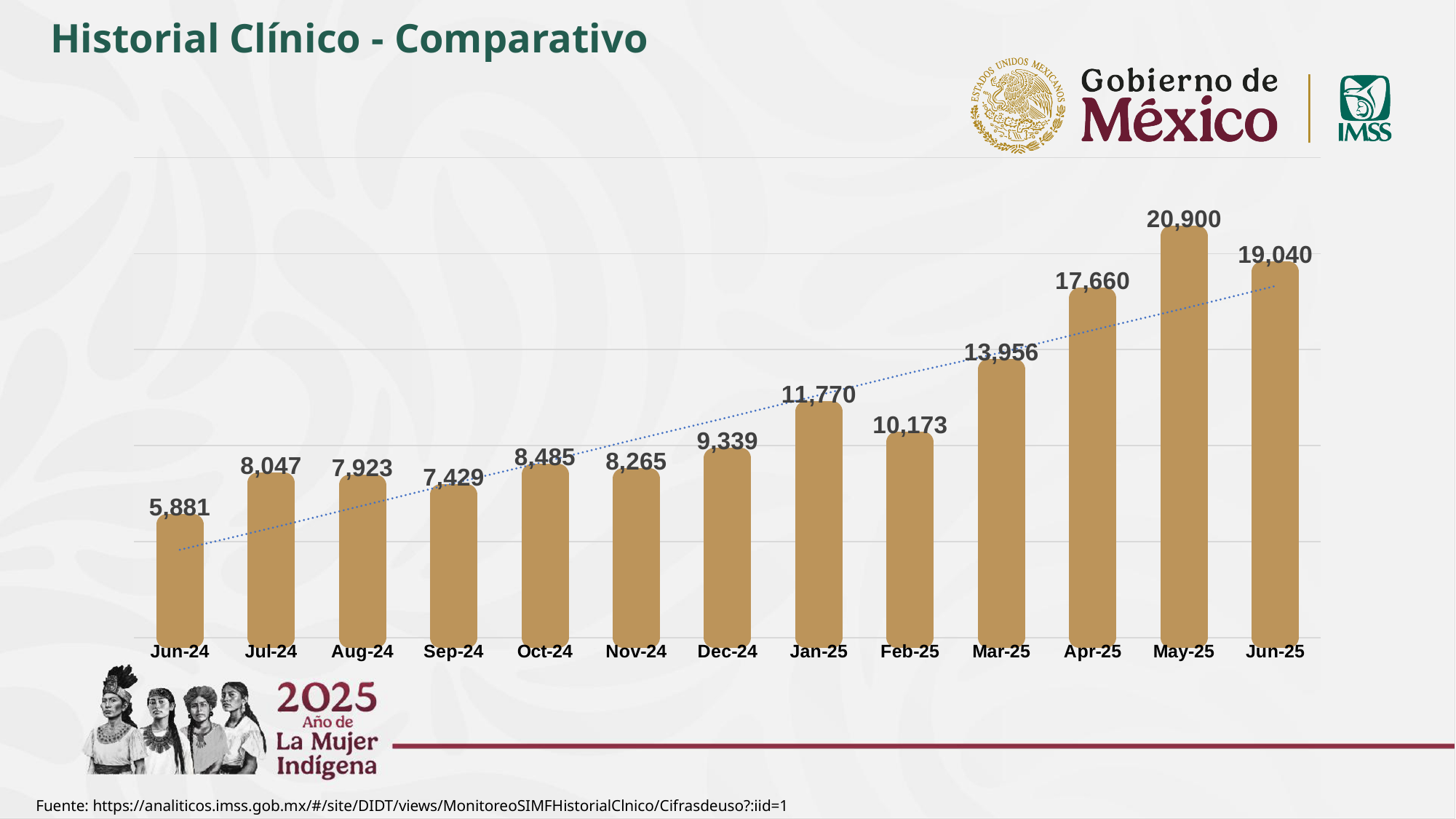
Which is larger, the value for Oct-24 or the value for Nov-24? Oct-24 How many months are shown on the x axis? 13 Which is larger, the value for Feb-25 or the value for Jan-25? Jan-25 What is the value for Jun-24? 5,881 What kind of chart is shown on the slide? Bar chart Which month has the highest value? May-25 What is the value for Mar-25? 13,956 What is the difference between the values for May-25 and Jun-25? 1,860 Which month has the lowest value? Jun-24 What is the value for Jun-25? 19,040 Do the values generally rise or fall from Jun-24 to Jun-25? Rise What is the difference between the values for Jan-25 and Dec-24? 2,431